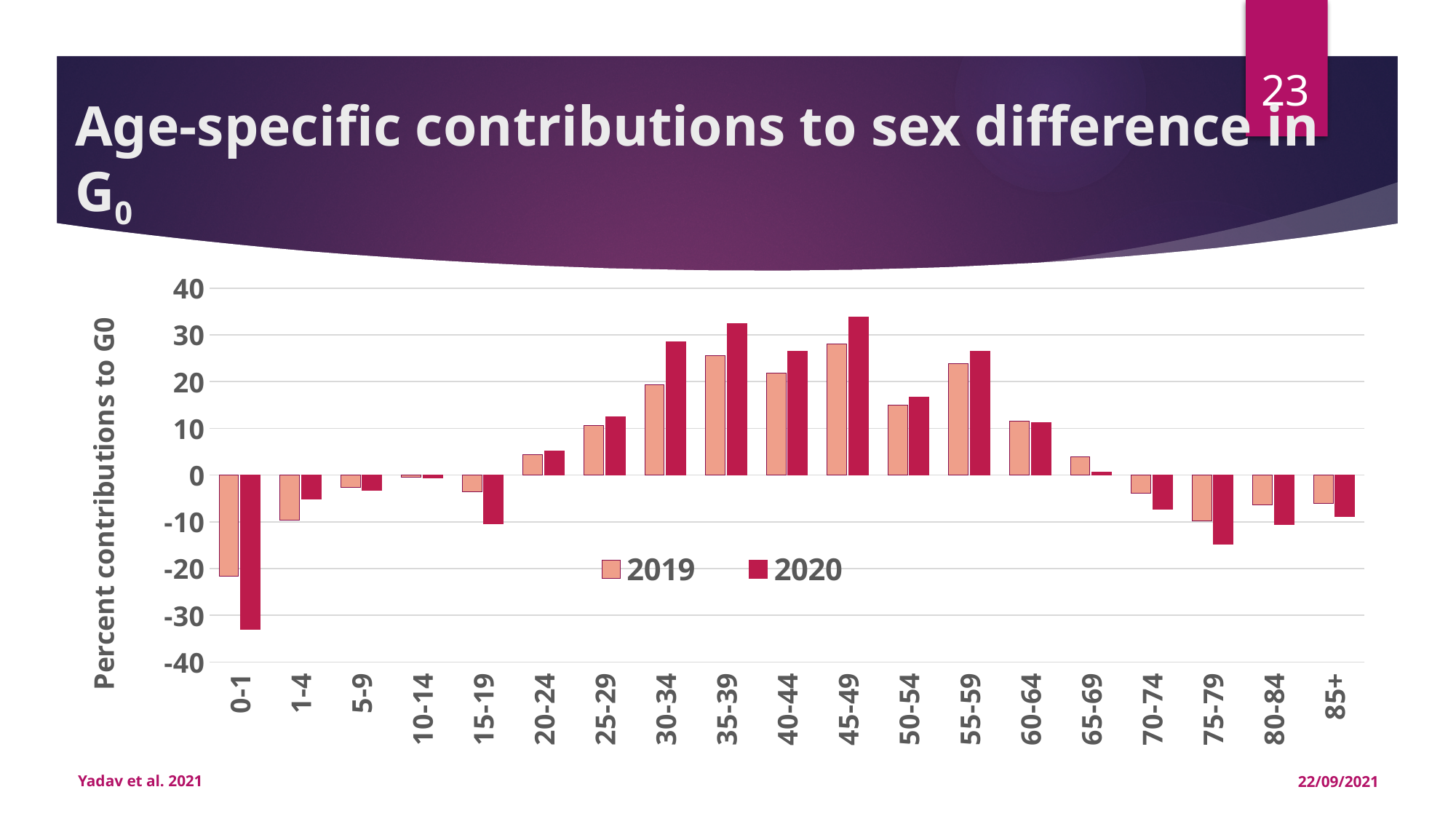
Is the value for 2020 in the 45-49 age group greater or less than 30? greater How many series does the legend list? 2 What kind of chart is shown on the slide? bar chart Which age group has the lowest value for 2020? 0-1 Is the value for 2020 in the 0-1 age group greater or less than -30? less For the 45-49 age group, which series has the larger value, 2019 or 2020? 2020 Which age group has the highest value for 2020? 45-49 What is the title of the vertical axis? Percent contributions to G0 Which age group has the lowest value for 2019? 0-1 Which age group has the highest value for 2019? 45-49 How many age groups are shown on the x axis? 19 Is the value for 2020 in the 75-79 age group greater or less than -10? less